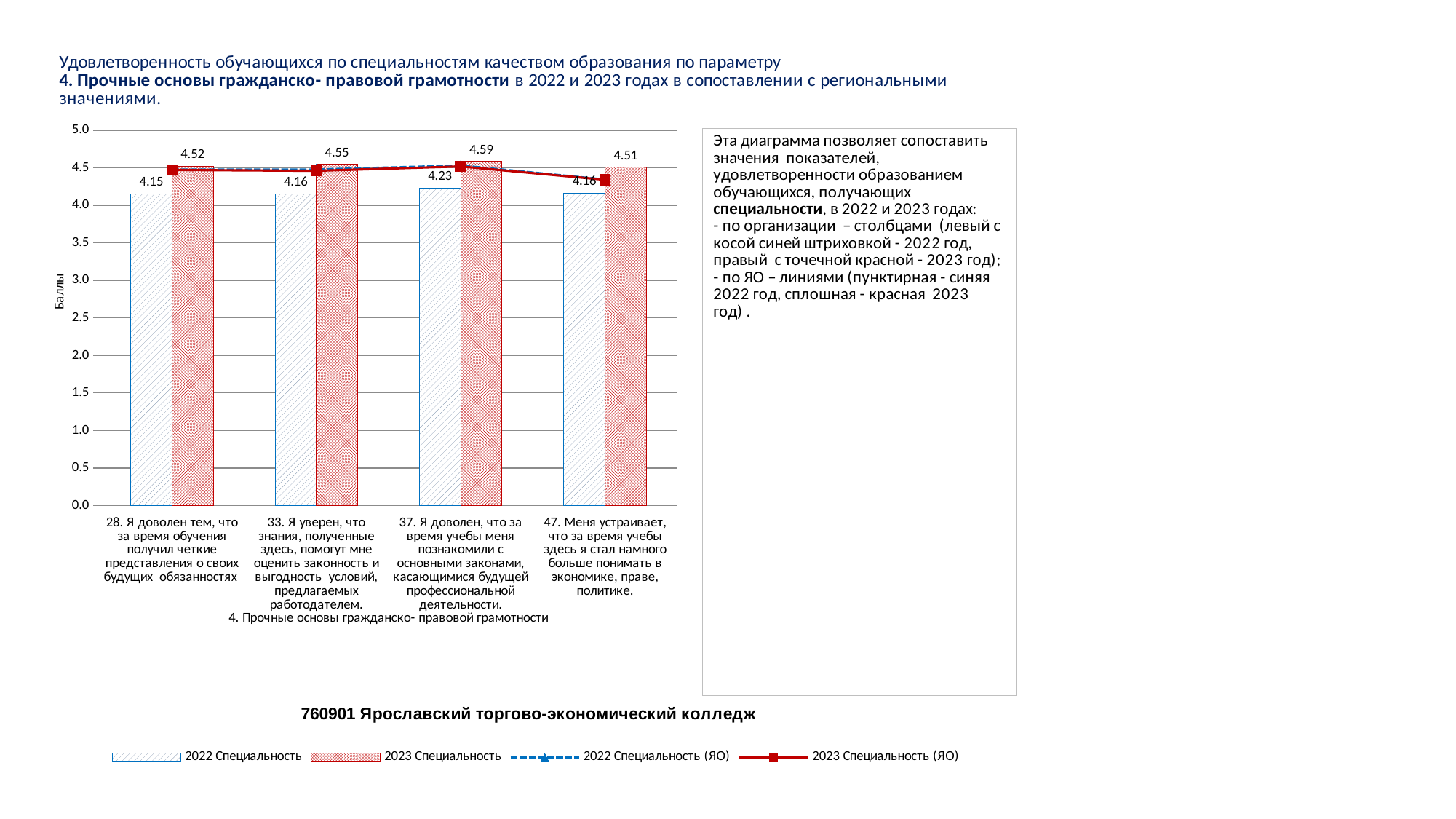
What is the label of the y axis? Баллы Which item has the lowest 2023 Специальность value? 47. Меня устраивает, что за время учебы здесь я стал намного больше понимать в экономике, праве, политике. Is the 2022 Специальность value for item 47 greater or less than 4.5? less What is the 2022 Специальность value for item 28 (Я доволен тем, что за время обучения получил четкие представления о своих будущих обязанностях)? 4.15 How many series does the legend list? 4 What is the difference between the 2023 and 2022 Специальность values for item 33? 0.39 Which item has the highest 2023 Специальность value? 37. Я доволен, что за время учебы меня познакомили с основными законами, касающимися будущей профессиональной деятельности. What kind of chart is shown on the slide? Combined bar and line chart How many survey items (categories) are shown on the x axis? 4 For item 37, which is larger: the 2022 Специальность bar or the 2023 Специальность bar? 2023 Специальность What is the 2023 Специальность value for item 47 (Меня устраивает, что за время учебы здесь я стал намного больше понимать в экономике, праве, политике)? 4.51 What is the 2023 Специальность value for item 37 (Я доволен, что за время учебы меня познакомили с основными законами...)? 4.59